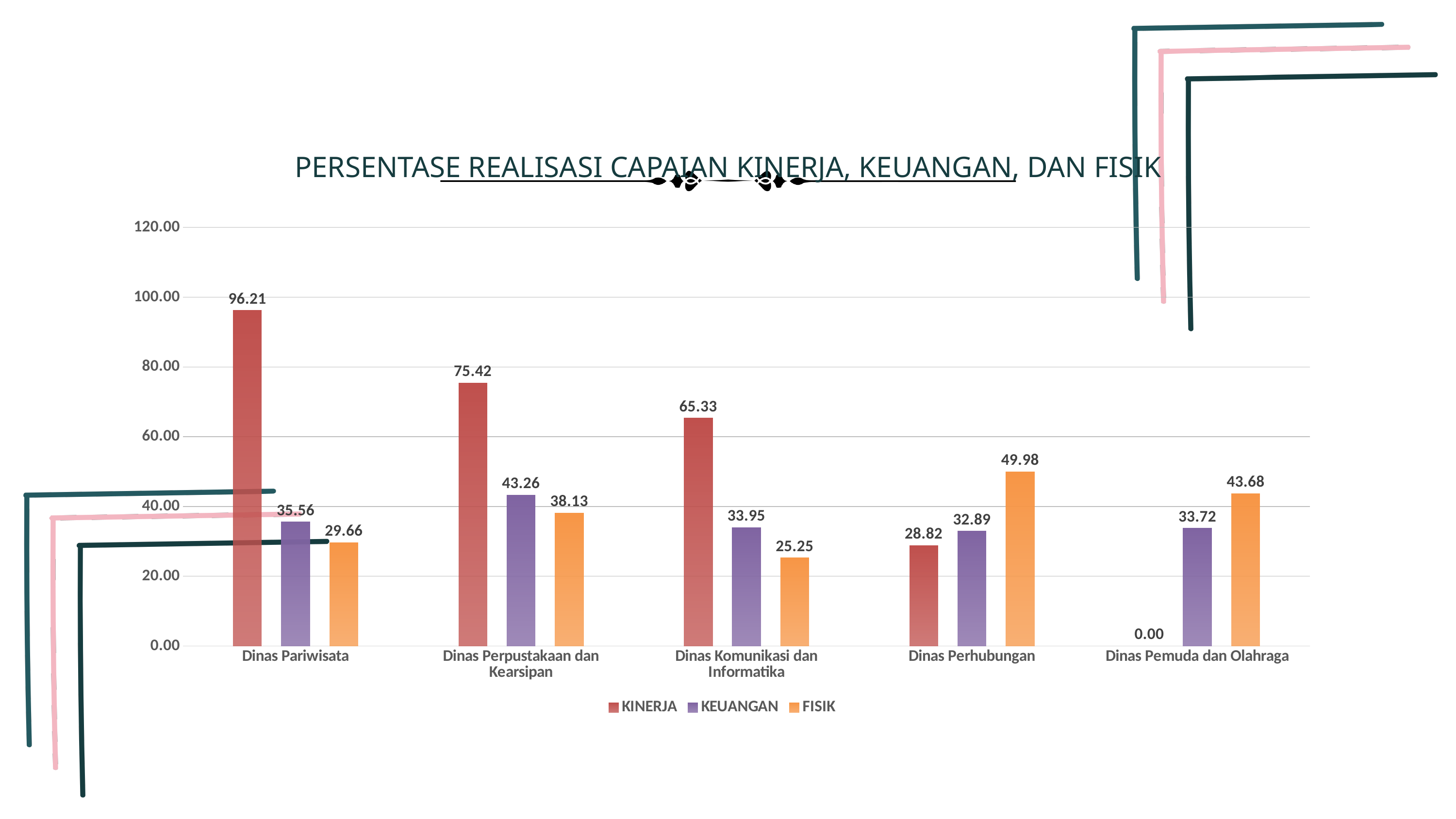
What kind of chart is shown on the slide? bar chart Which category has the highest KINERJA value? Dinas Pariwisata What is the KINERJA value for Dinas Pemuda dan Olahraga? 0.00 Which category has the lowest FISIK value? Dinas Komunikasi dan Informatika What is the KINERJA value for Dinas Pariwisata? 96.21 How many series does the legend list? 3 How many categories are shown on the x axis? 5 What is the FISIK value for Dinas Perhubungan? 49.98 Which is larger for Dinas Perhubungan: the KINERJA value or the FISIK value? FISIK What is the difference between the KINERJA and FISIK values for Dinas Komunikasi dan Informatika? 40.08 Is the KINERJA value for Dinas Perpustakaan dan Kearsipan greater or less than 80.00? less What is the KEUANGAN value for Dinas Perpustakaan dan Kearsipan? 43.26